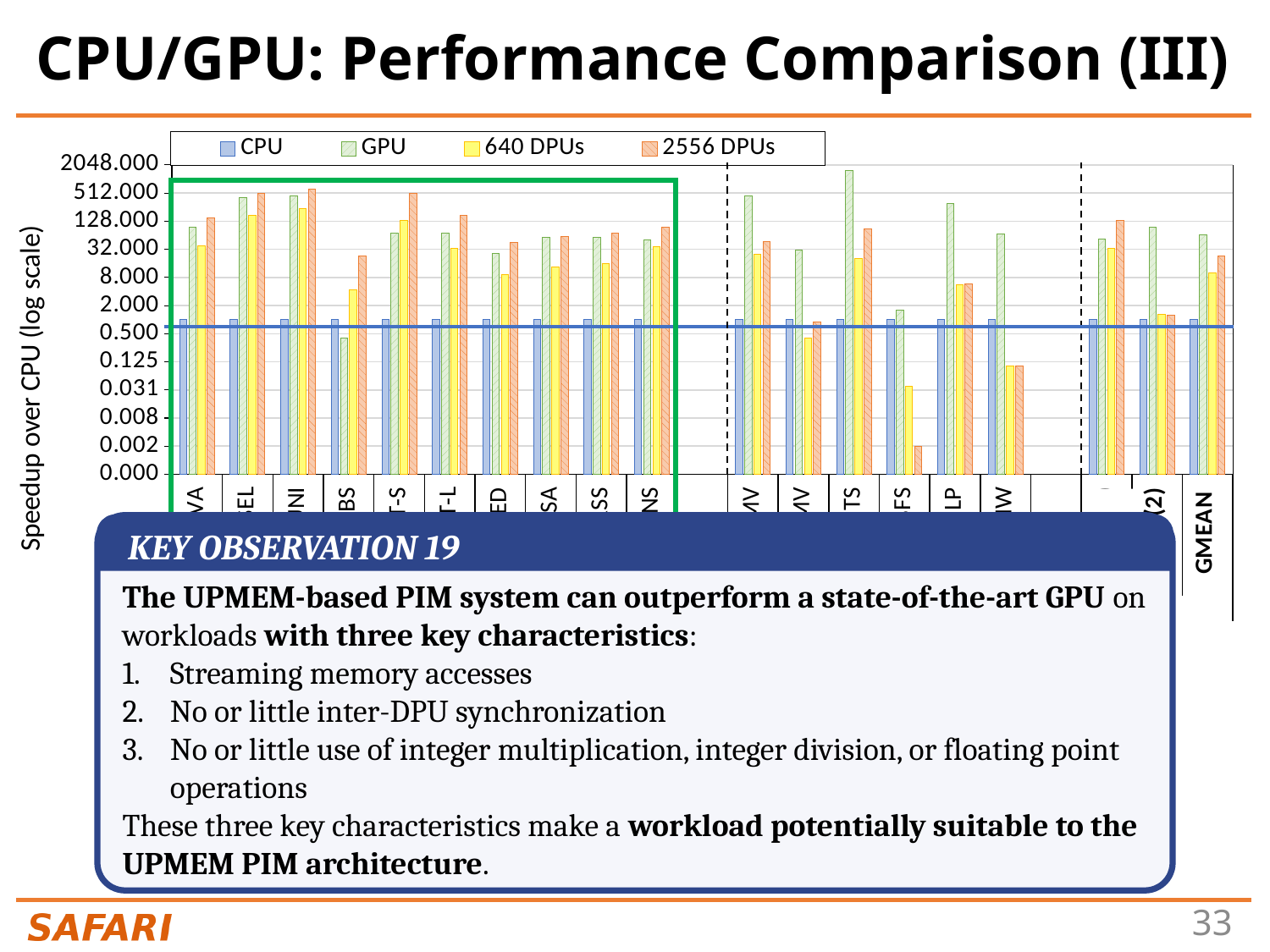
Is the GPU value for GMEAN greater or less than 32.000? greater Which series has the lowest value for GMEAN? CPU How many series does the chart's legend list? 4 Is the 640 DPUs value for GMEAN greater or less than 32.000? less Which series has the highest value for GMEAN? GPU What kind of chart is shown on the slide? Bar chart Is the 2556 DPUs value for GMEAN greater or less than 8.000? greater What is the highest tick value shown on the y axis? 2048.000 What are the four series listed in the chart's legend? CPU, GPU, 640 DPUs, 2556 DPUs For GMEAN, which is larger: the 2556 DPUs value or the 640 DPUs value? 2556 DPUs What is the label of the chart's y axis? Speedup over CPU (log scale) For GMEAN, which is larger: the GPU value or the 2556 DPUs value? GPU